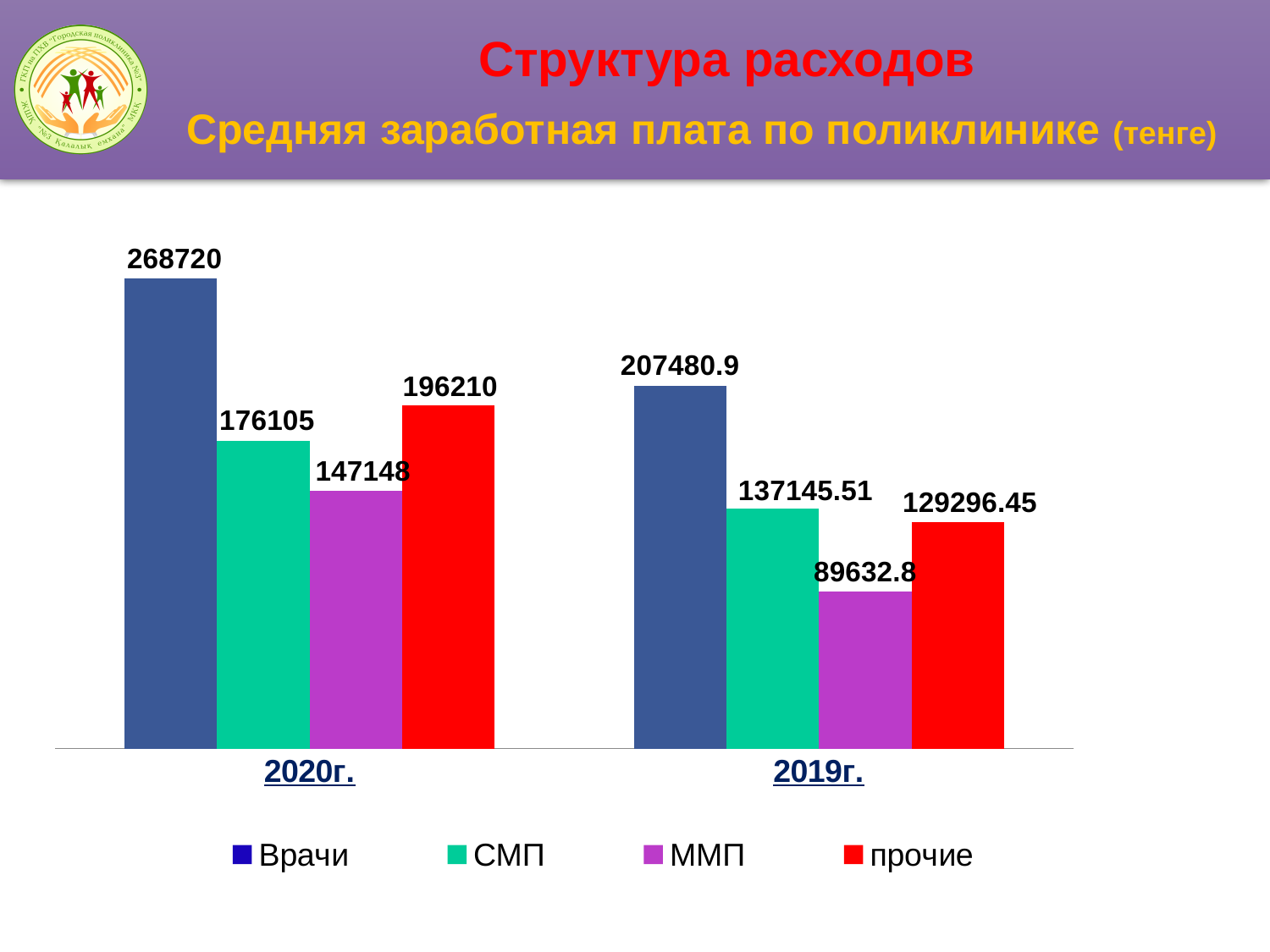
What colour represents the ММП series? Purple How many series does the legend list? 4 What is the difference between the прочие values for 2020г. and 2019г.? 66913.55 Which is larger: СМП in 2020г. or прочие in 2020г.? прочие in 2020г. What is the value for СМП in 2020г.? 176105 What is the value for Врачи in 2020г.? 268720 What kind of chart is shown on the slide? Bar chart What is the difference between the Врачи values for 2020г. and 2019г.? 61239.1 What is the value for прочие in 2019г.? 129296.45 What is the value for ММП in 2019г.? 89632.8 Which series has the lowest value in 2019г.? ММП Which series has the highest value in 2020г.? Врачи